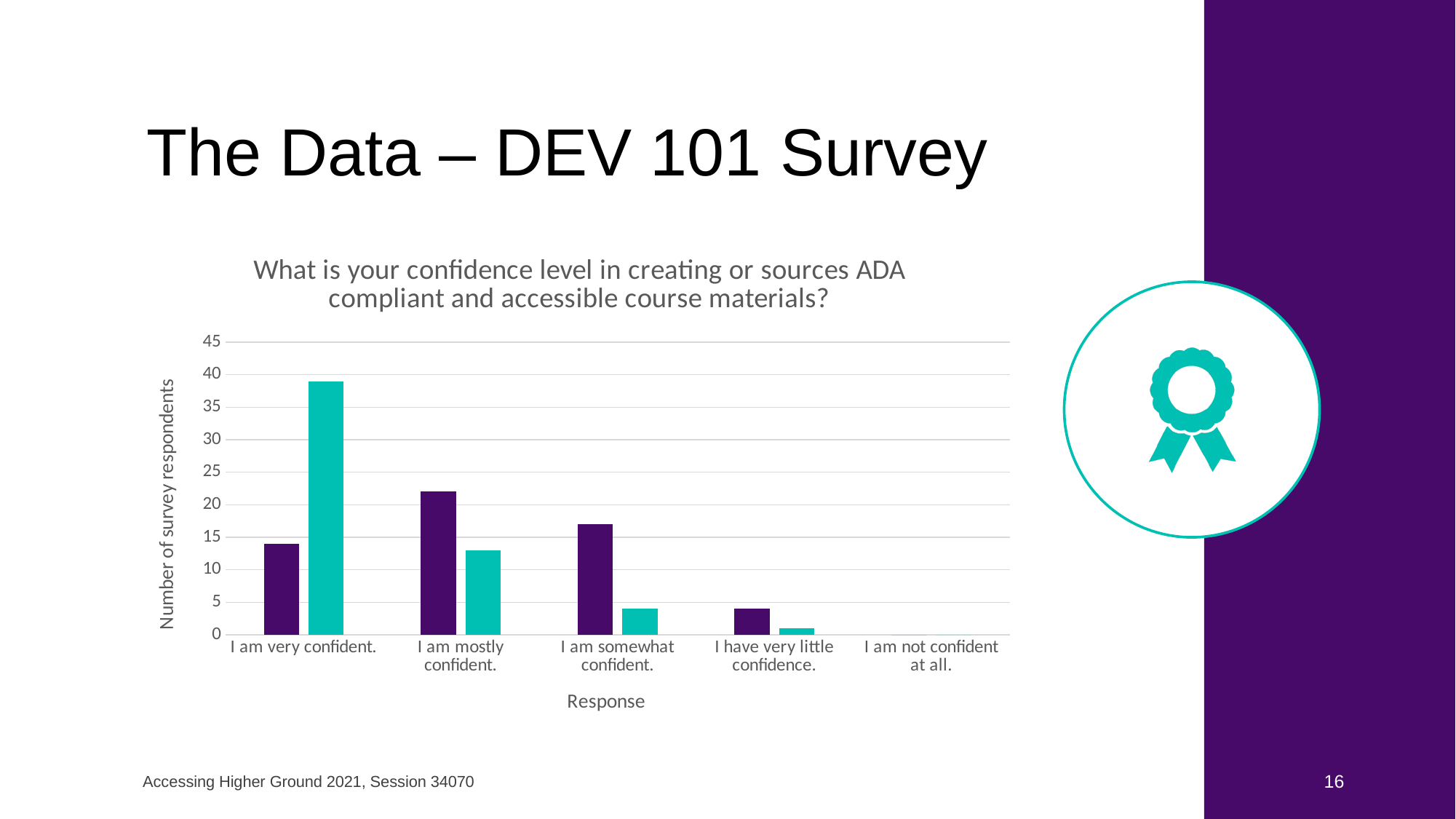
What is the title of the chart? What is your confidence level in creating or sources ADA compliant and accessible course materials? For "I am very confident.", which bar is taller, the purple or the teal one? teal Is the teal bar for "I am very confident." greater or less than 35? greater Do the teal bars rise or fall moving from left to right along the x axis? fall Is the purple bar for "I am somewhat confident." greater or less than 20? less What kind of chart is shown on the slide? bar chart Is the purple bar for "I am mostly confident." greater or less than 25? less For "I am mostly confident.", which bar is taller, the purple or the teal one? purple How many response categories are shown on the x axis? 5 Which response has the tallest teal bar? I am very confident. Which response has the tallest purple bar? I am mostly confident. What is the label of the y axis? Number of survey respondents